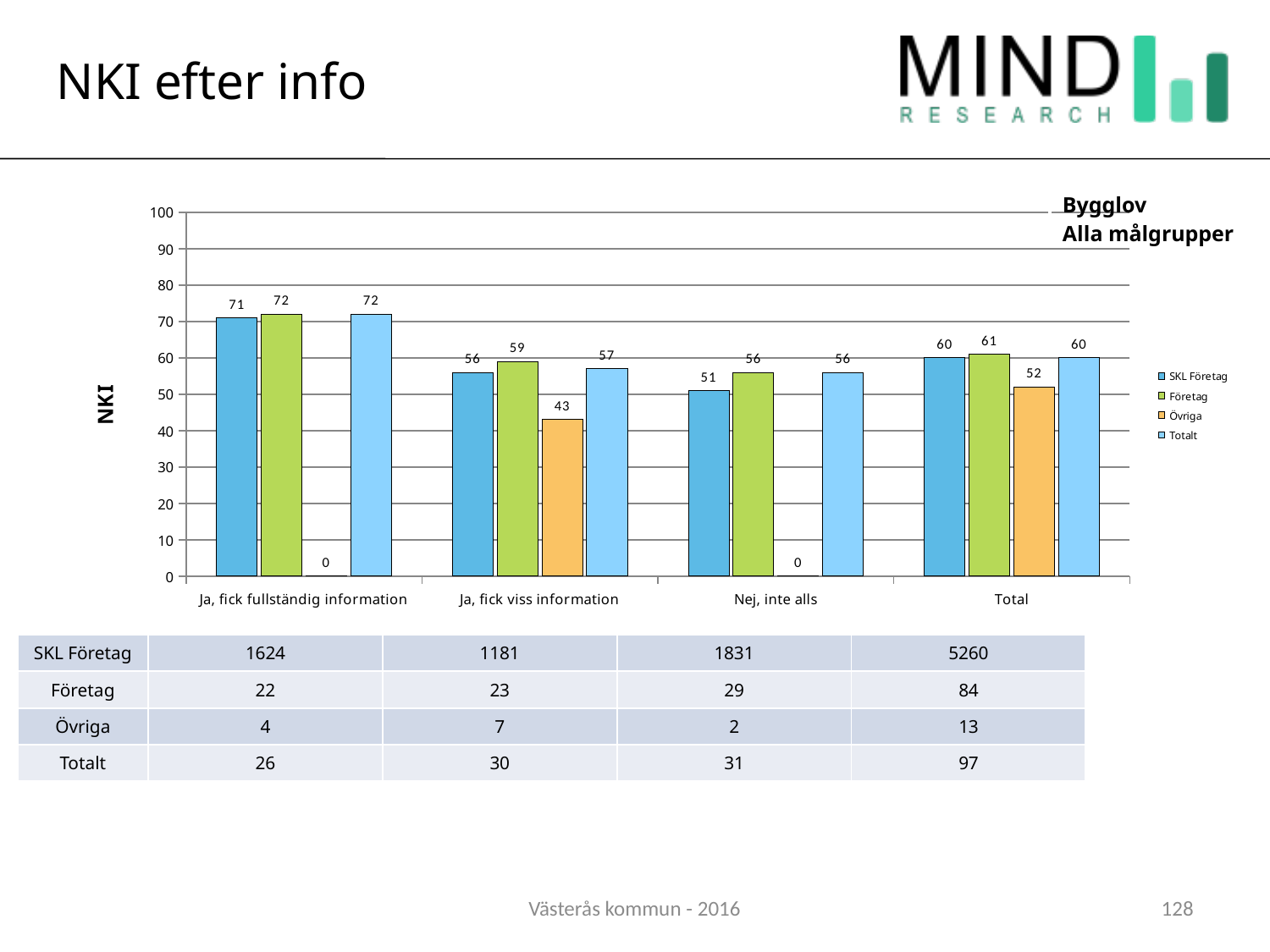
Which category has the highest Totalt value? Ja, fick fullständig information In the 'Nej, inte alls' category, what is the difference between the Företag value and the SKL Företag value? 5 What is the NKI value for SKL Företag in the 'Nej, inte alls' category? 51 What type of chart is shown on the slide? Bar chart Which category has the lowest SKL Företag value? Nej, inte alls How many categories are shown on the x axis of the chart? 4 What is the difference between the Totalt value for 'Ja, fick fullständig information' and the Totalt value for 'Nej, inte alls'? 16 Which is larger: the Övriga value for 'Total' or the Övriga value for 'Ja, fick viss information'? Total How many series does the chart legend list? 4 What is the NKI value for Företag in the 'Ja, fick viss information' category? 59 Is the Totalt value for the 'Total' category greater or less than 50? greater What is the NKI value for Övriga in the 'Ja, fick viss information' category? 43